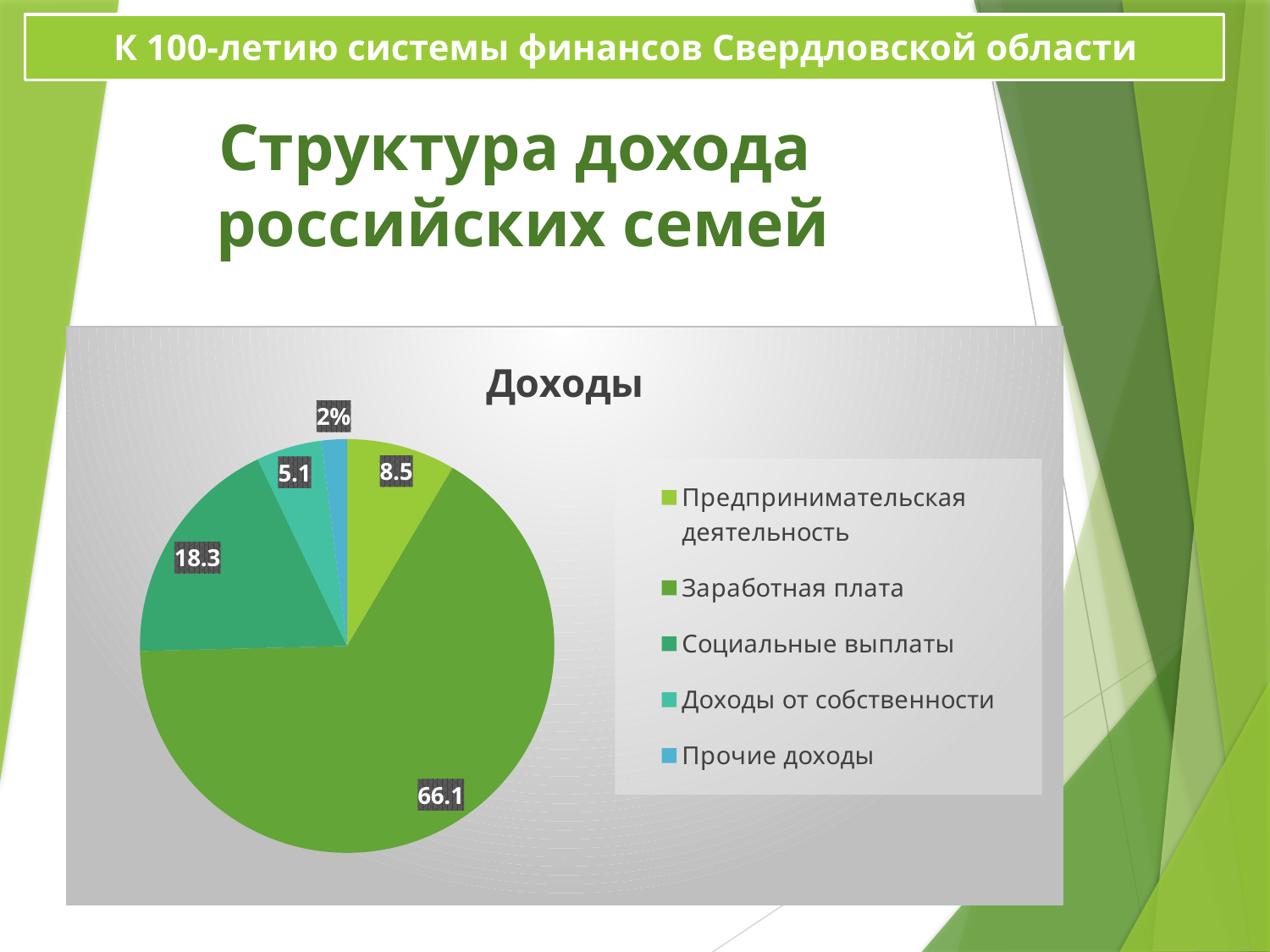
What is the difference between the values for Заработная плата and Социальные выплаты? 47.8 What is the value shown for Социальные выплаты? 18.3 Which is larger, Социальные выплаты or Предпринимательская деятельность? Социальные выплаты Which category has the largest slice of the pie? Заработная плата What is the value shown for Предпринимательская деятельность? 8.5 What is the value shown for Прочие доходы? 2% Which category has the smallest slice of the pie? Прочие доходы What is the value shown for Доходы от собственности? 5.1 What is the value shown for Заработная плата? 66.1 What type of chart is shown on the slide? Pie chart What is the title of the chart? Доходы How many slices does the pie chart have? 5